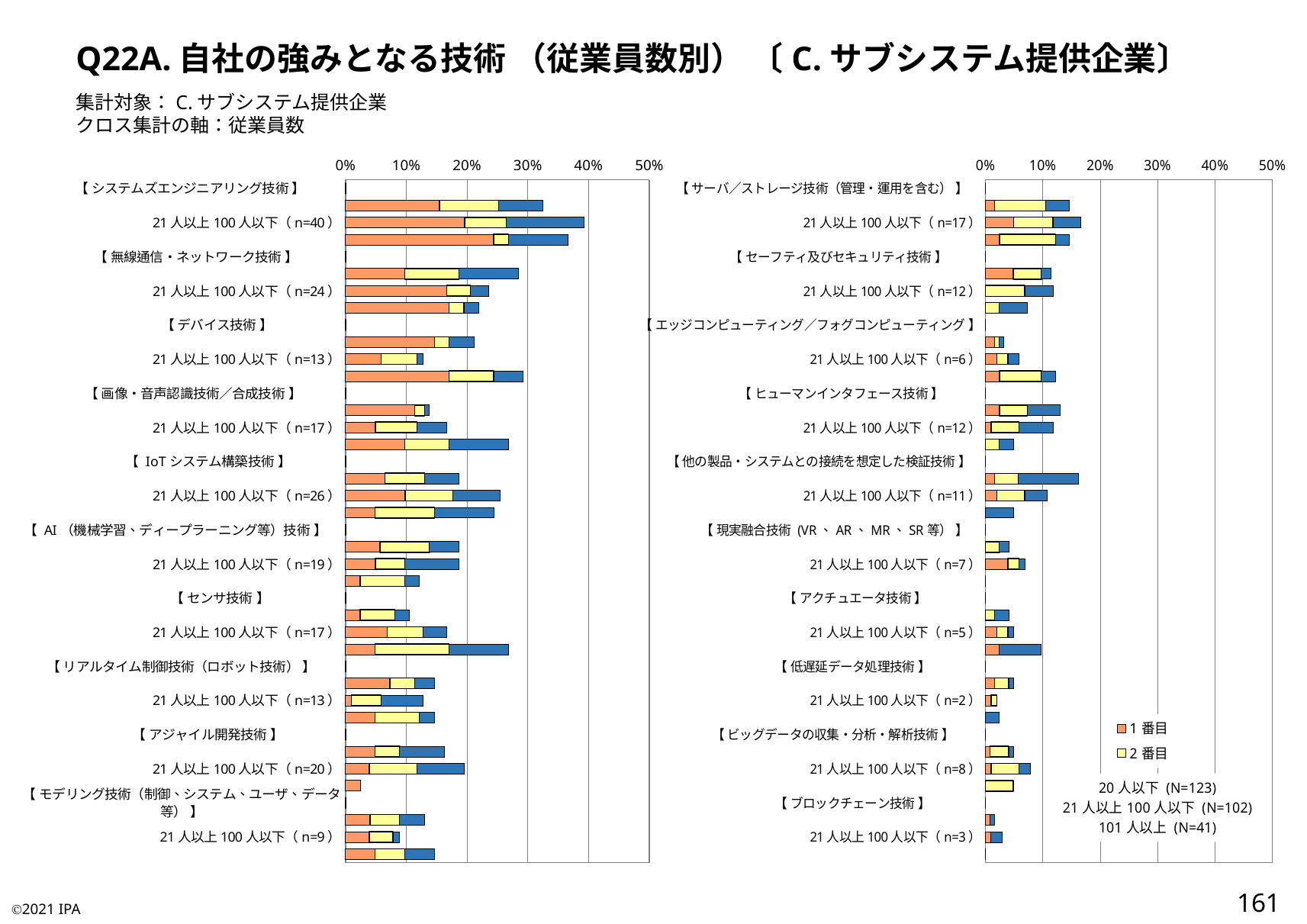
In the left chart, which technology group has the longest total bars overall? システムズエンジニアリング技術 In the left chart, is the total bar for 21人以上100人以下 (n=40) under システムズエンジニアリング技術 greater or less than 30%? greater What is the maximum value shown on the x axis of both charts? 50% In the right chart, is the total bar for 21人以上100人以下 (n=17) under サーバ／ストレージ技術 greater or less than 10%? greater What is the n value shown for 21人以上100人以下 under システムズエンジニアリング技術 in the left chart? n=40 In the right chart, under 他の製品・システムとの接続を想定した検証技術, which has the longer total bar: the first (20人以下) bar or the 21人以上100人以下 (n=11) bar? 20人以下 In the left chart, which has the longer total bar: 21人以上100人以下 under システムズエンジニアリング技術 or 21人以上100人以下 under 無線通信・ネットワーク技術? システムズエンジニアリング技術 How many technology groups are listed in the right chart? 10 How many technology groups are listed in the left chart? 10 In the left chart, is the total bar for 101人以上 under AI（機械学習、ディープラーニング等）技術 greater or less than 20%? less What kind of chart is used on the left side of the slide? bar chart